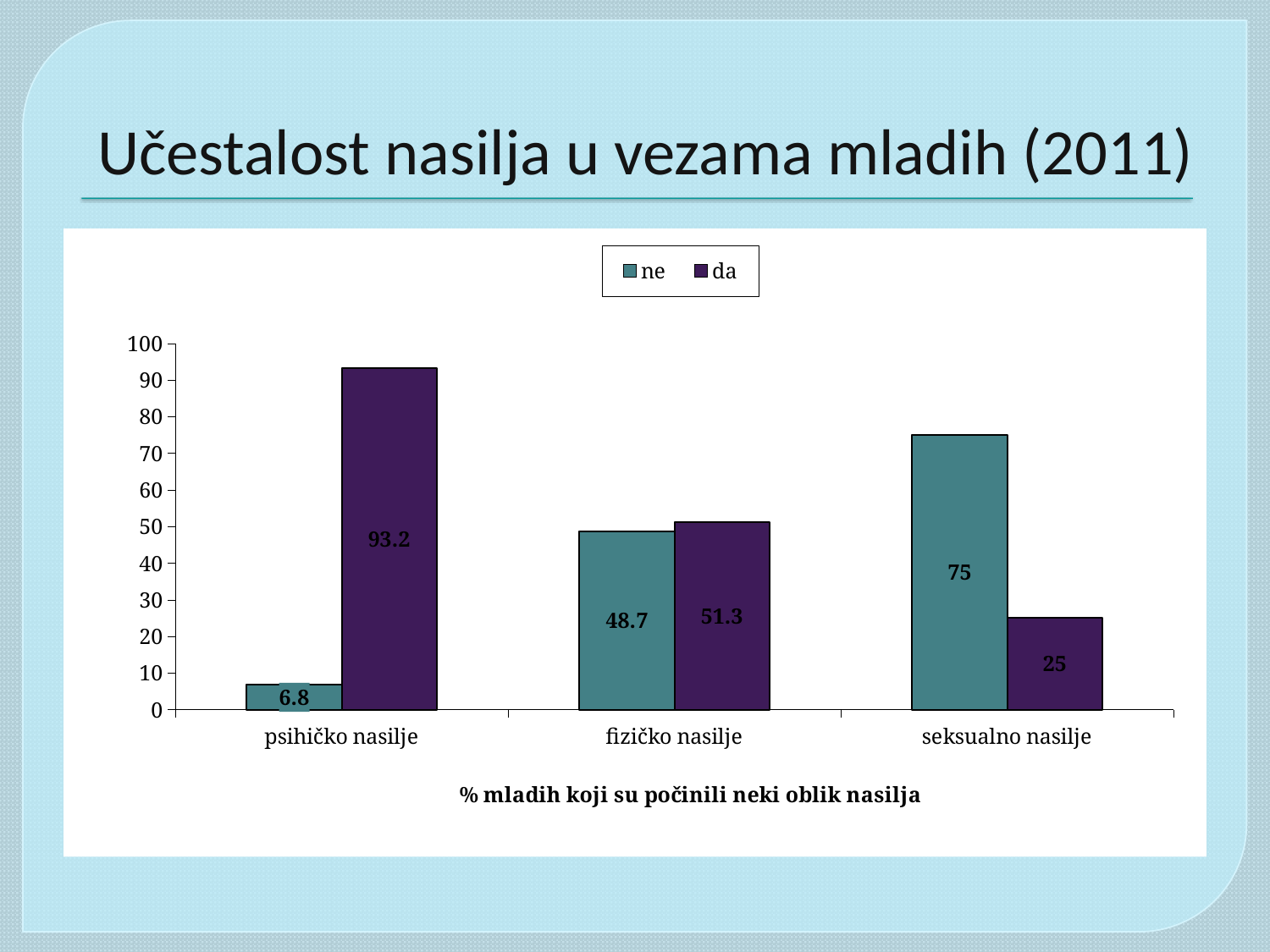
How many series does the legend list? 2 What kind of chart is shown on the slide? bar chart What is the value for "ne" in the seksualno nasilje category? 75 How many categories are shown on the x axis? 3 Which category has the lowest "ne" value? psihičko nasilje What is the value for "da" in the psihičko nasilje category? 93.2 Which is larger for fizičko nasilje, the "ne" value or the "da" value? da What is the difference between the "da" and "ne" values for psihičko nasilje? 86.4 What is the value for "ne" in the fizičko nasilje category? 48.7 What is the difference between the "ne" and "da" values for seksualno nasilje? 50 Which category has the highest "da" value? psihičko nasilje What is the value for "da" in the seksualno nasilje category? 25